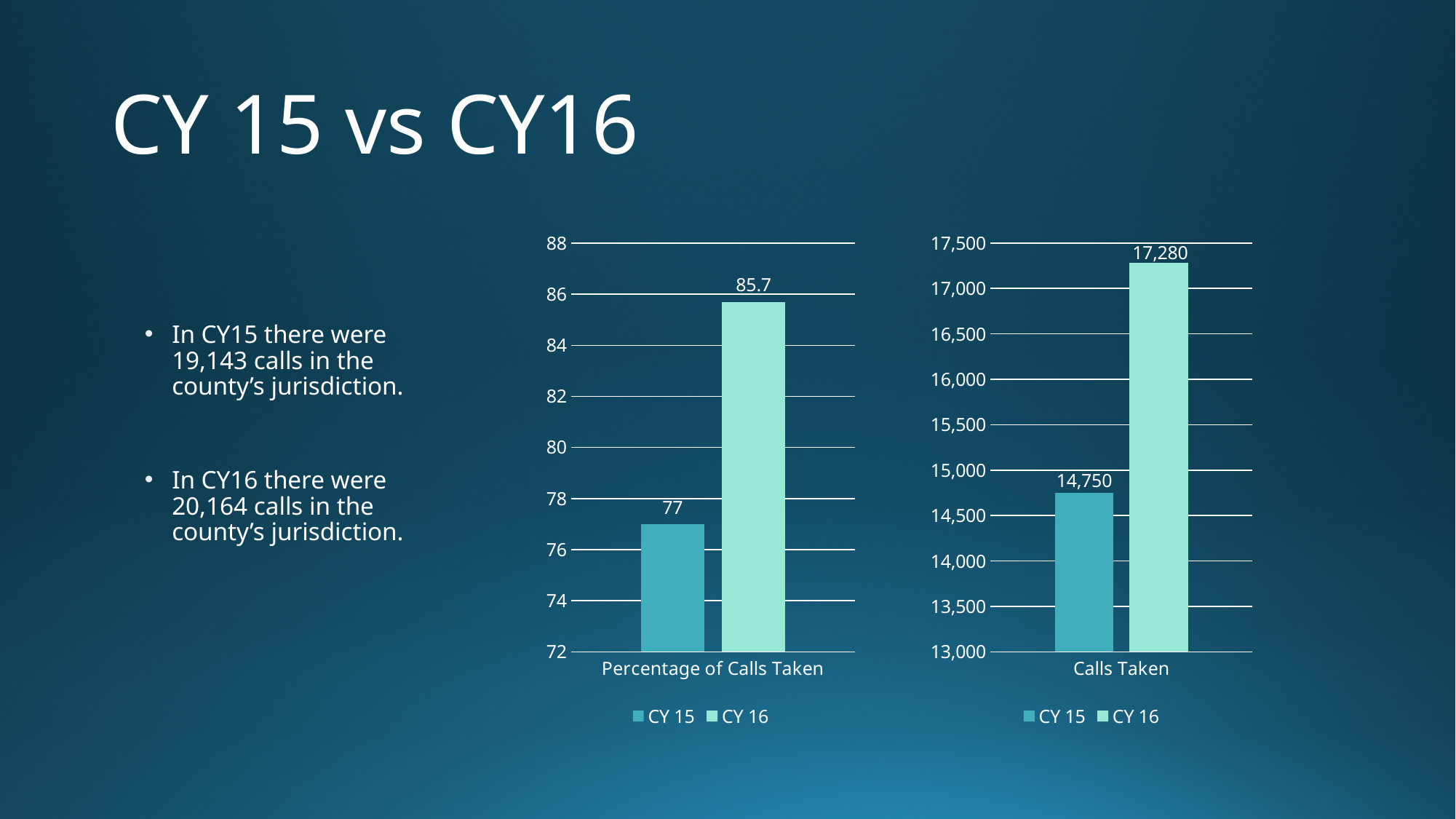
In the Percentage of Calls Taken chart, what is the value for CY 16? 85.7 In the Calls Taken chart, which series has the higher value? CY 16 In the Calls Taken chart, what is the difference between the CY 16 and CY 15 values? 2,530 In the Calls Taken chart, what is the value for CY 16? 17,280 In the Percentage of Calls Taken chart, what is the value for CY 15? 77 In the Calls Taken chart, what is the value for CY 15? 14,750 In the Percentage of Calls Taken chart, which series has the lower value? CY 15 How many series does the legend of the Calls Taken chart list? 2 What is the category label on the x axis of the left chart? Percentage of Calls Taken In the Percentage of Calls Taken chart, is the CY 16 value greater or less than 84? greater What kind of chart is the Calls Taken chart? bar chart In the Percentage of Calls Taken chart, what is the difference between the CY 16 and CY 15 values? 8.7